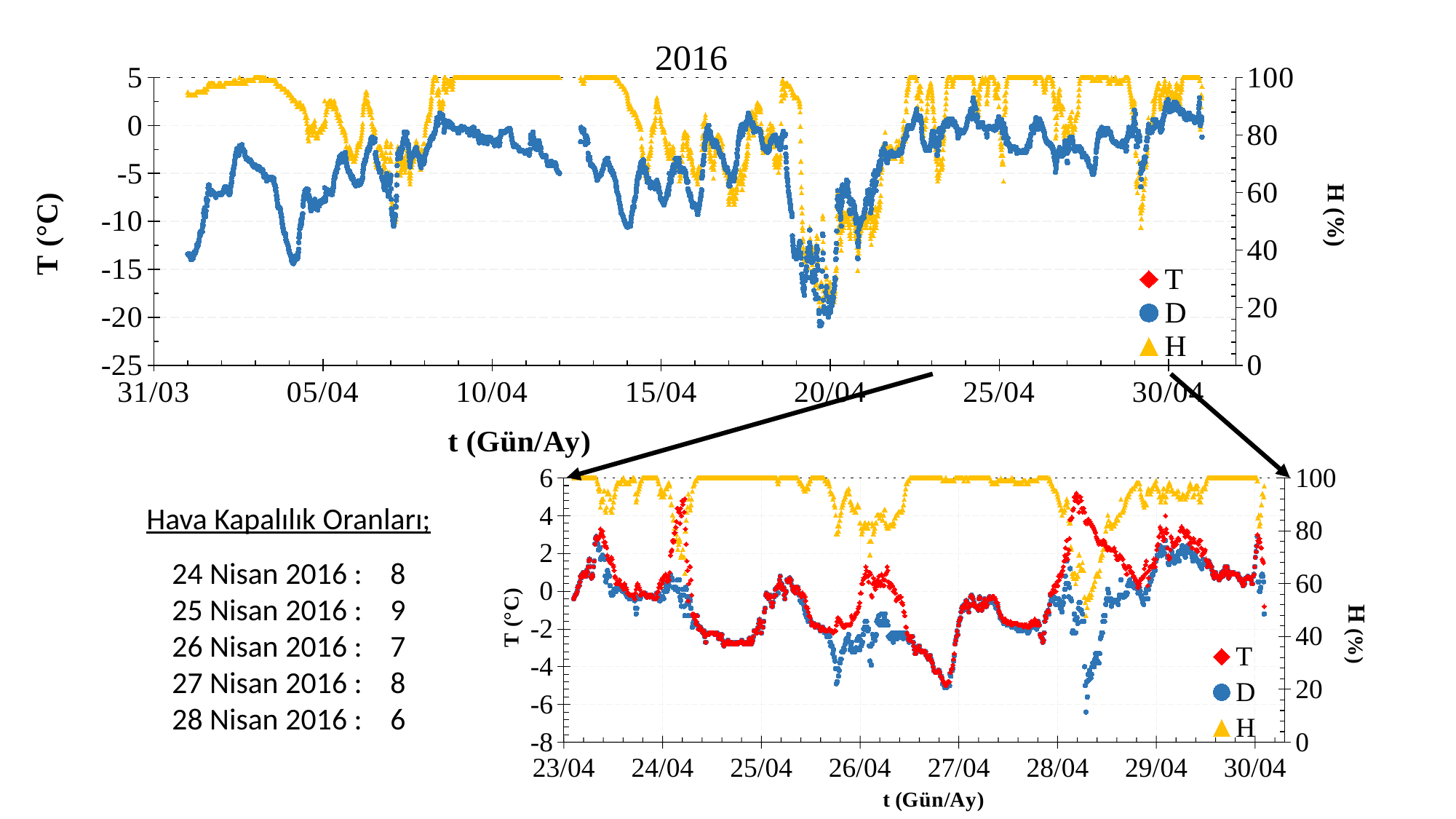
How many date ticks are labelled on the x axis of the bottom chart? 8 In the bottom chart, does the T series rise or fall between 26/04 and 27/04? fall What is the title of the top chart? 2016 In the bottom chart, is the peak value of the T series just after 28/04 greater or less than 4? greater What kind of chart is the top chart titled "2016"? scatter chart How many series does the legend of the top chart list? 3 What are the legend entries of the bottom chart? T, D, H What is the maximum value shown on the right-hand H (%) axis of the top chart? 100 In the bottom chart, is the lowest value of the D series just after 28/04 greater or less than -4? less What is the minimum value shown on the left T (°C) axis of the bottom chart? -8 In the top chart, is the lowest value of the D series around 20/04 greater or less than -15? less